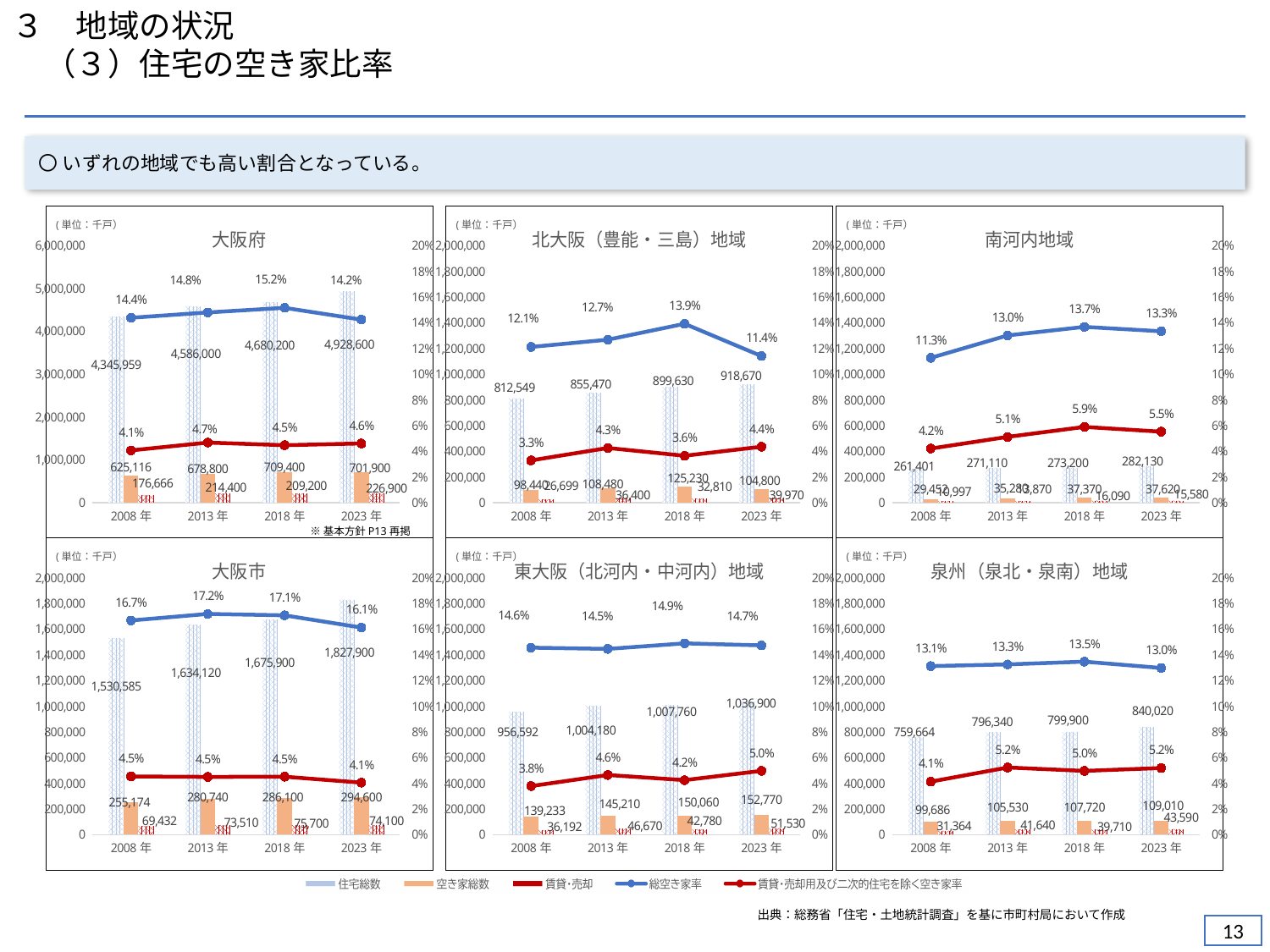
In the 北大阪（豊能・三島）地域 chart, what is the 空き家総数 value for 2023年? 104,800 How many series does the shared legend at the bottom of the slide list? 5 In the 大阪府 chart, what is the 住宅総数 value for 2023年? 4,928,600 In the 大阪市 chart, does the 住宅総数 rise or fall from 2008年 to 2023年? rise How many years are shown on the x axis of the 泉州（泉北・泉南）地域 chart? 4 In the 大阪府 chart, what is the 総空き家率 value for 2018年? 15.2% In the 南河内地域 chart, what is the difference in 住宅総数 between 2023年 and 2008年? 20,729 In the 南河内地域 chart, which year has the lowest 総空き家率? 2008年 In the 北大阪（豊能・三島）地域 chart, which year has the highest 総空き家率? 2018年 In the 大阪市 chart, what is the 総空き家率 value for 2013年? 17.2% In the 東大阪（北河内・中河内）地域 chart, what is the 賃貸・売却 value for 2023年? 51,530 In the 泉州（泉北・泉南）地域 chart, which is larger, the 空き家総数 for 2008年 or for 2023年? 2023年